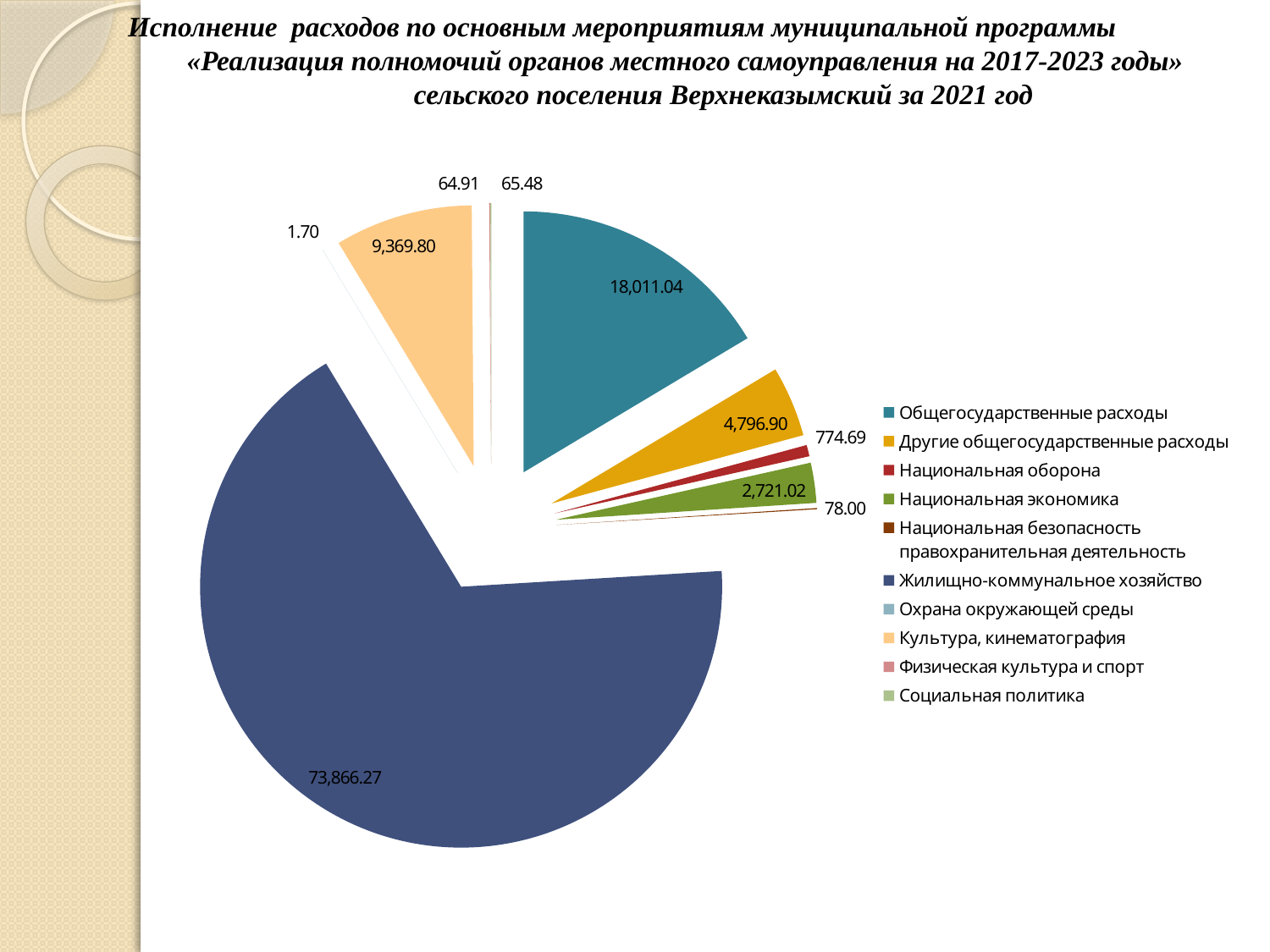
What is the value for Культура, кинематография? 9,369.80 What is the value for Другие общегосударственные расходы? 4,796.90 How many categories does the legend of the pie chart list? 10 What type of chart is shown on the slide? pie chart What is the value for Национальная экономика? 2,721.02 Which is larger, Общегосударственные расходы or Культура, кинематография? Общегосударственные расходы What is the value for Национальная оборона? 774.69 Which category has the largest slice of the pie? Жилищно-коммунальное хозяйство What is the value for Жилищно-коммунальное хозяйство? 73,866.27 What is the value for Общегосударственные расходы? 18,011.04 What is the difference between Другие общегосударственные расходы and Национальная экономика? 2,075.88 What is the difference between Общегосударственные расходы and Культура, кинематография? 8,641.24